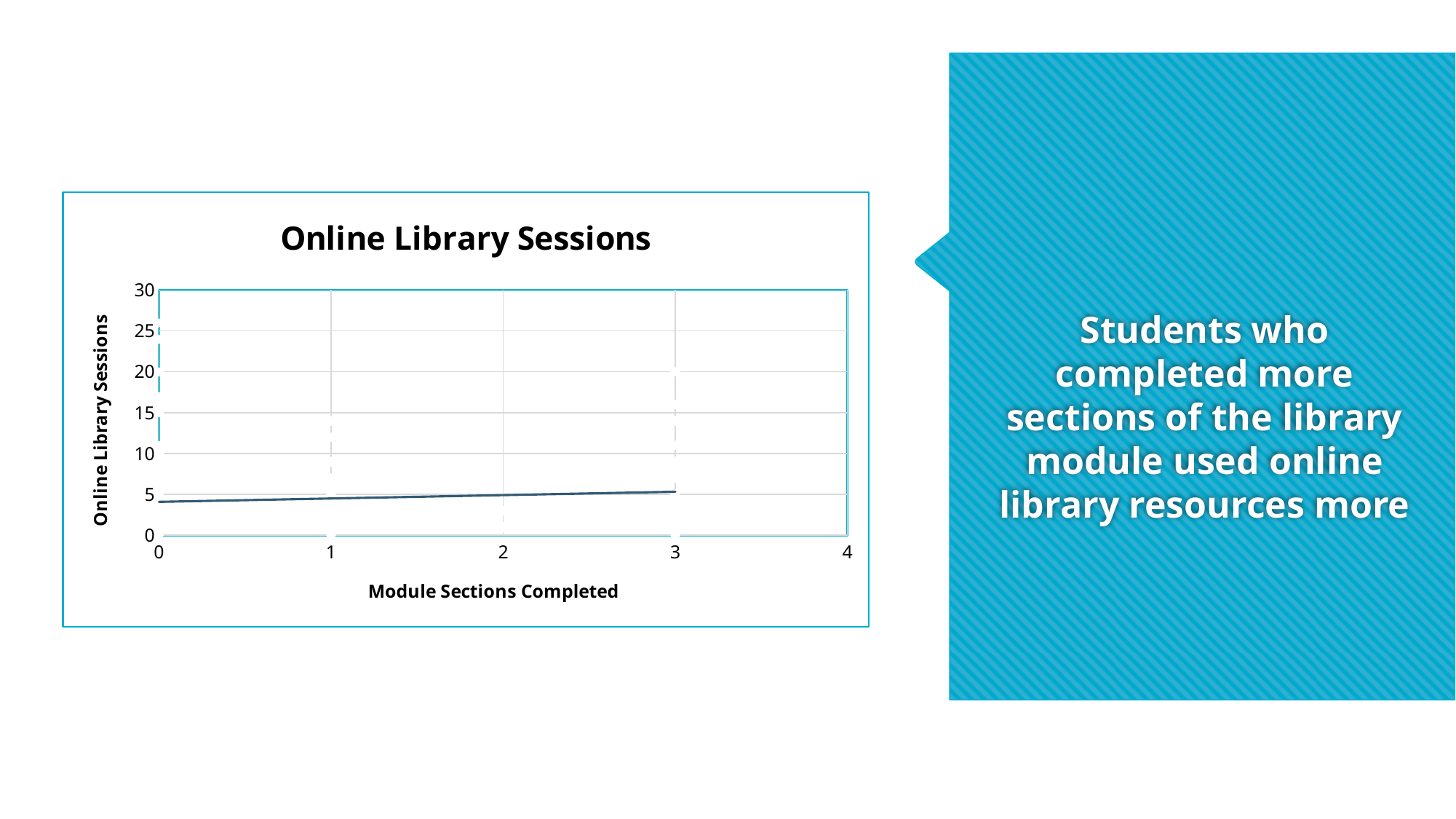
What is the highest value shown on the y axis of the chart? 30 Is the value for 0 Module Sections Completed greater or less than 10? less Is the value for 0 Module Sections Completed greater or less than 5? less Which is larger, the value at 0 Module Sections Completed or the value at 3 Module Sections Completed? 3 Module Sections Completed What kind of chart is shown on the slide? line chart Do the values rise or fall as Module Sections Completed increases from 0 to 3? rise Is the value for 3 Module Sections Completed greater or less than 10? less What is the title of the chart? Online Library Sessions What is the label on the x axis of the chart? Module Sections Completed